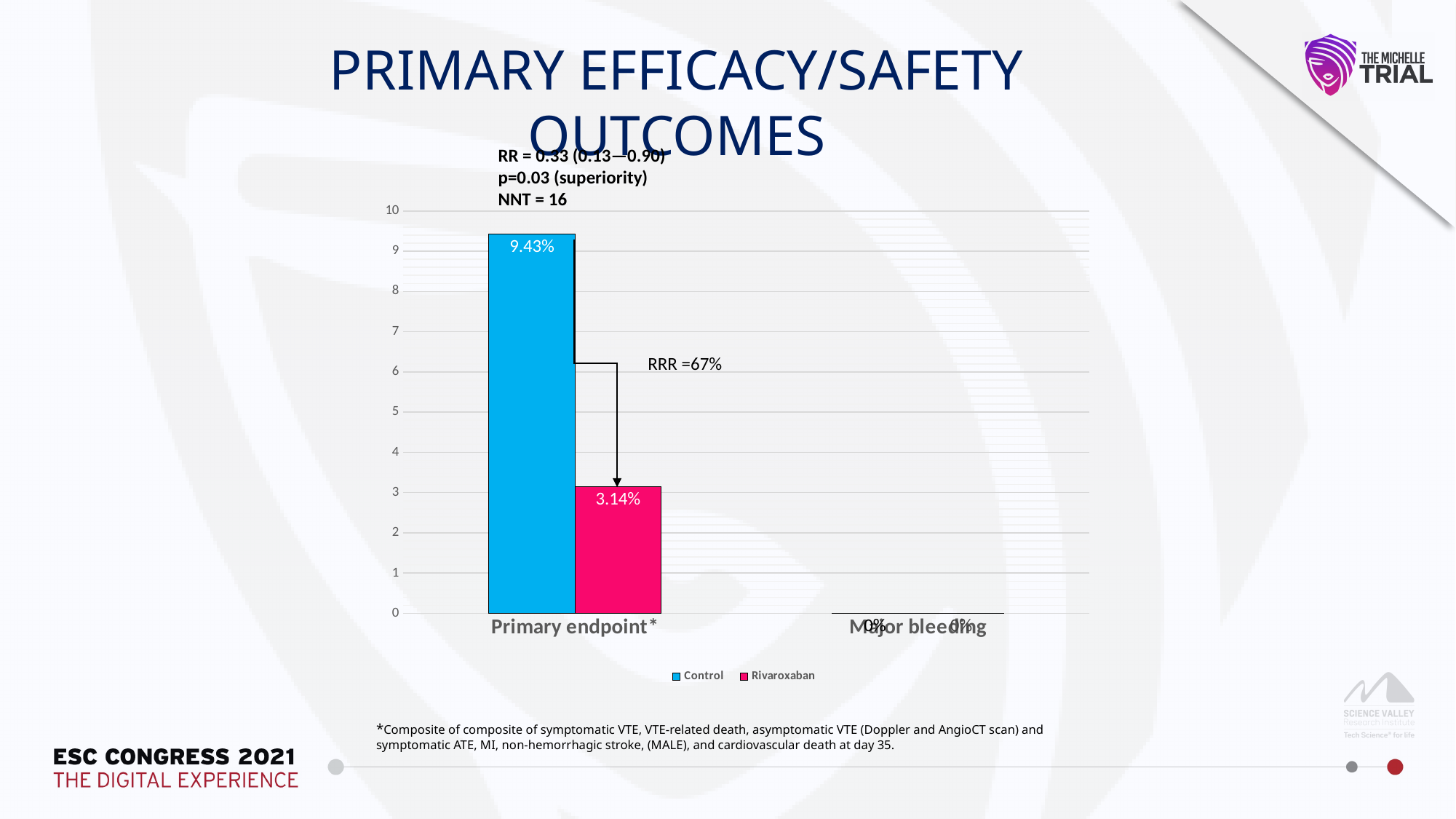
What is the Rivaroxaban value for Major bleeding? 0% What kind of chart is shown on the slide? Bar chart How many categories are shown on the x axis of the chart? 2 What is the Control value for the Primary endpoint? 9.43% What relative risk reduction (RRR) is annotated on the chart for the Primary endpoint? 67% What is the difference between the Control and Rivaroxaban values for the Primary endpoint? 6.29% Which series has the higher value for the Primary endpoint, Control or Rivaroxaban? Control Is the Rivaroxaban value for the Primary endpoint greater or less than 4? less Is the Control value for the Primary endpoint greater or less than 9? greater How many series does the chart legend list? 2 What is the Rivaroxaban value for the Primary endpoint? 3.14% What is the Control value for Major bleeding? 0%